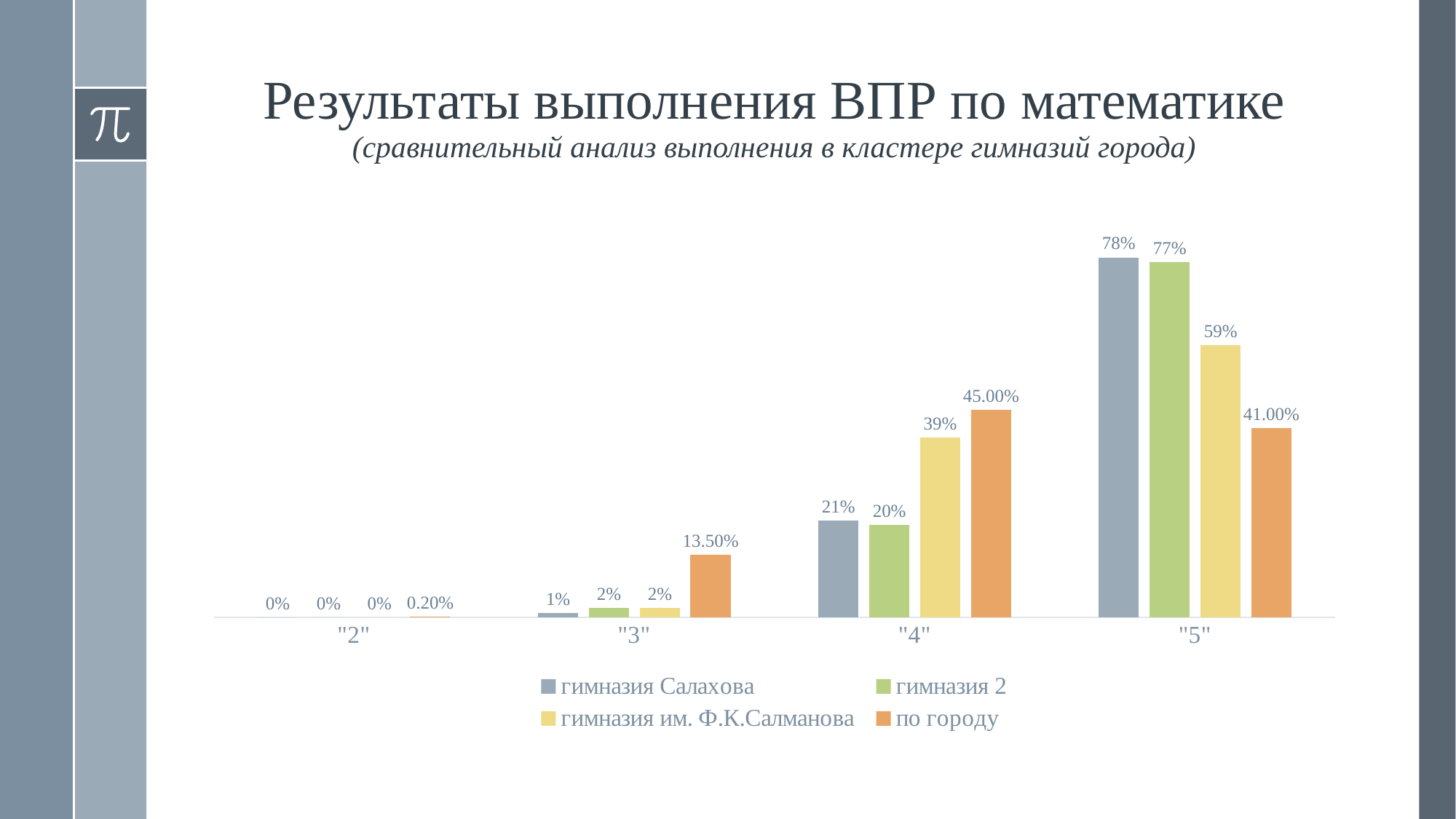
What is the value for по городу in category "2"? 0.20% Which is larger in category "4": гимназия Салахова or гимназия им. Ф.К.Салманова? гимназия им. Ф.К.Салманова Which series has the lowest value in category "5"? по городу How many categories are shown on the x axis? 4 What is the difference between гимназия Салахова and гимназия им. Ф.К.Салманова in category "5"? 19% How many series does the legend list? 4 What is the value for гимназия им. Ф.К.Салманова in category "4"? 39% What kind of chart is shown on the slide? bar chart Do the values for гимназия 2 rise or fall from category "2" to category "5"? rise What is the value for гимназия Салахова in category "5"? 78% Which series has the highest value in category "4"? по городу What is the value for по городу in category "3"? 13.50%